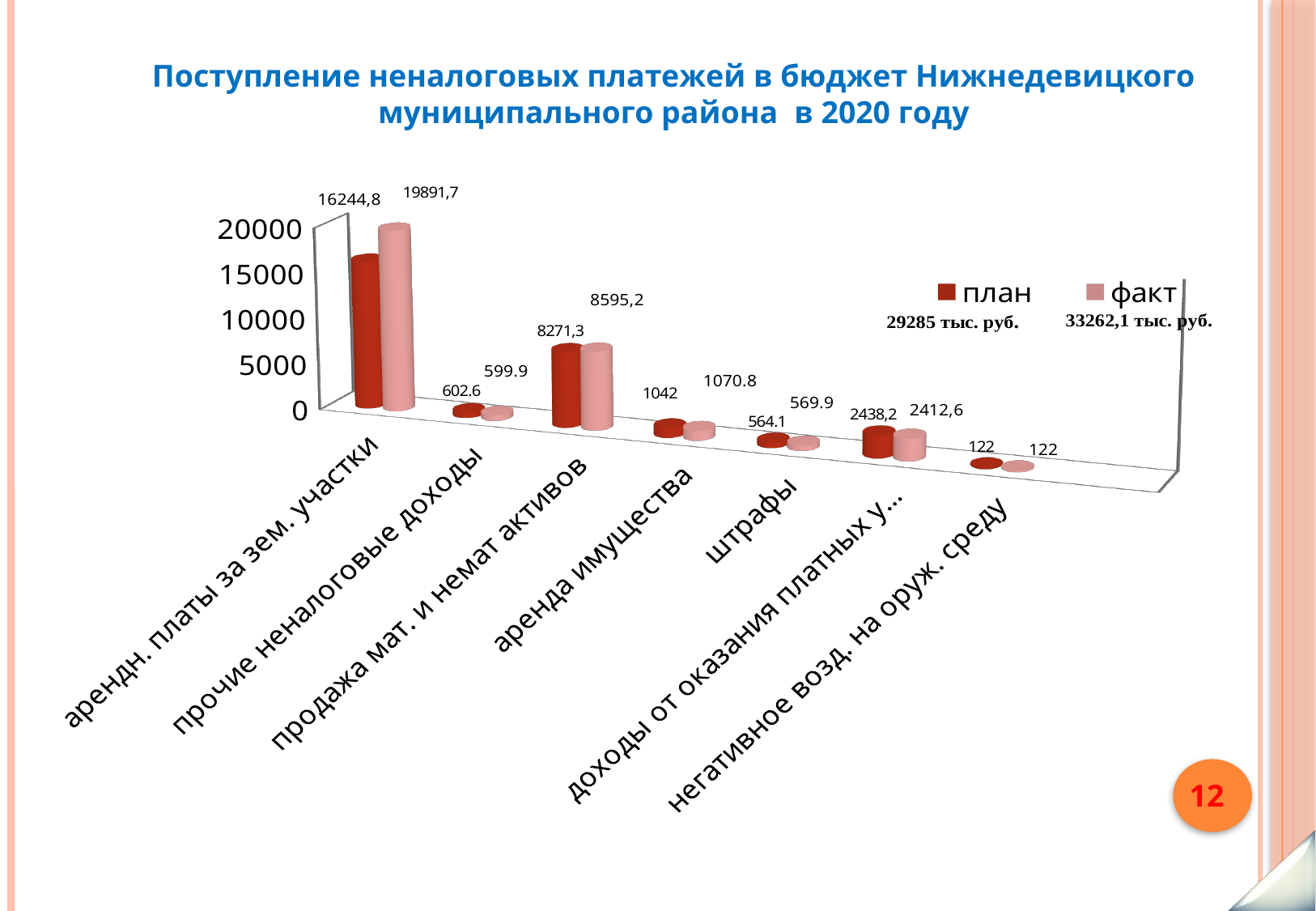
Which category has the lowest план value? негативное возд. на оруж. среду What is the difference between the факт and план values for продажа мат. и немат активов? 323,9 What is the план value for арендн. платы за зем. участки? 16244,8 What is the факт value for аренда имущества? 1070.8 Which category has the highest факт value? арендн. платы за зем. участки What is the факт value for продажа мат. и немат активов? 8595,2 What is the план value for доходы от оказания платных у...? 2438,2 Which is larger for прочие неналоговые доходы, the план value or the факт value? план How many series does the legend list? 2 What kind of chart is shown on the slide? bar chart What is the difference between the факт and план values for арендн. платы за зем. участки? 3646,9 How many categories are shown on the x axis? 7